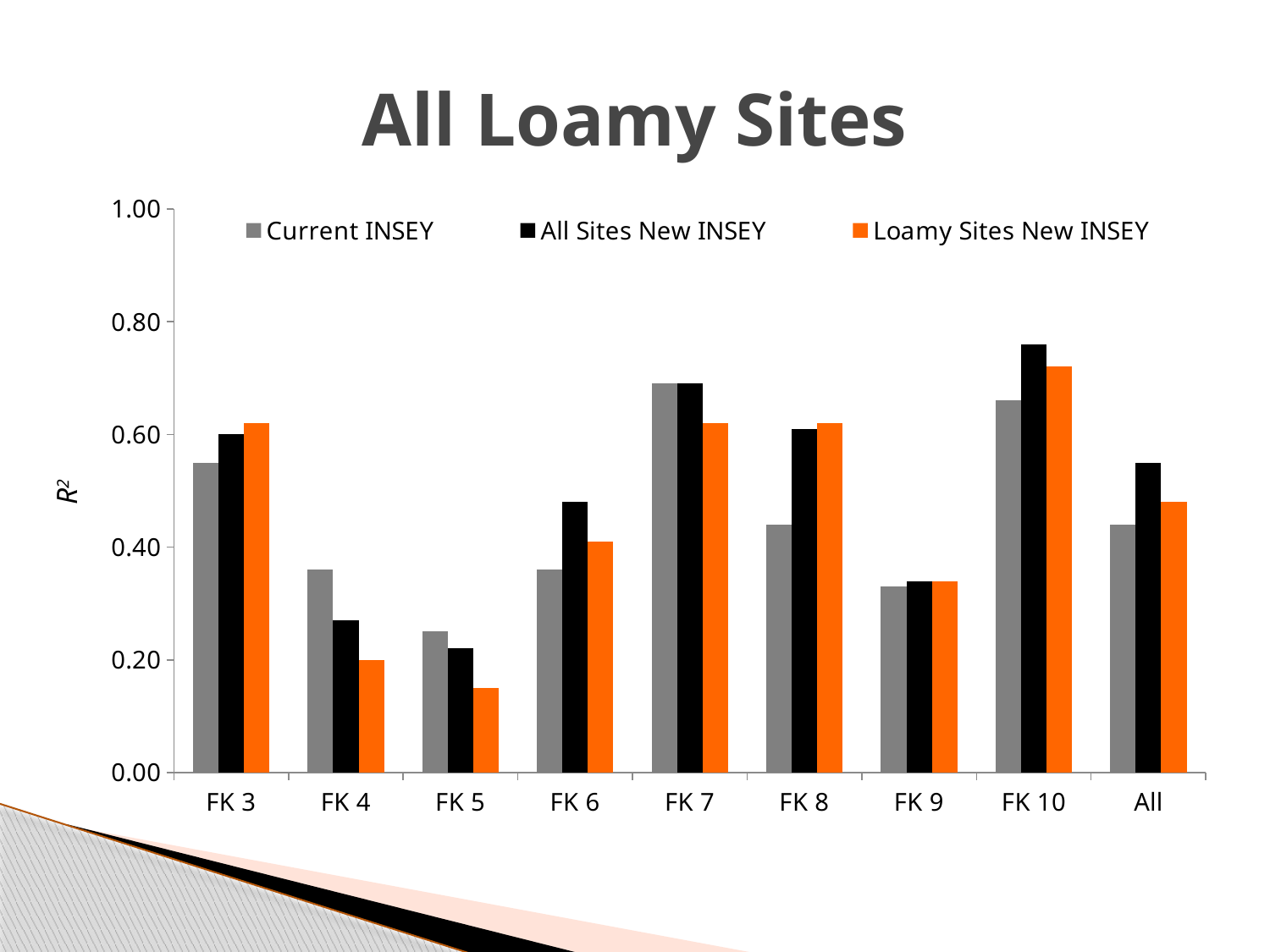
Which category has the lowest Current INSEY value? FK 5 What is the label on the y axis of the chart? R² How many categories are shown on the x axis? 9 How many series does the legend list? 3 For FK 6, which is larger: the Current INSEY value or the All Sites New INSEY value? All Sites New INSEY Is the Loamy Sites New INSEY value for FK 5 greater or less than 0.20? less Which category has the tallest bar in the chart? FK 10 Is the All Sites New INSEY value for FK 6 greater or less than 0.40? greater What kind of chart is shown on the slide? bar chart For FK 4, which is larger: the Current INSEY value or the Loamy Sites New INSEY value? Current INSEY Is the Current INSEY value for FK 7 greater or less than 0.60? greater Which category has the highest All Sites New INSEY value? FK 10